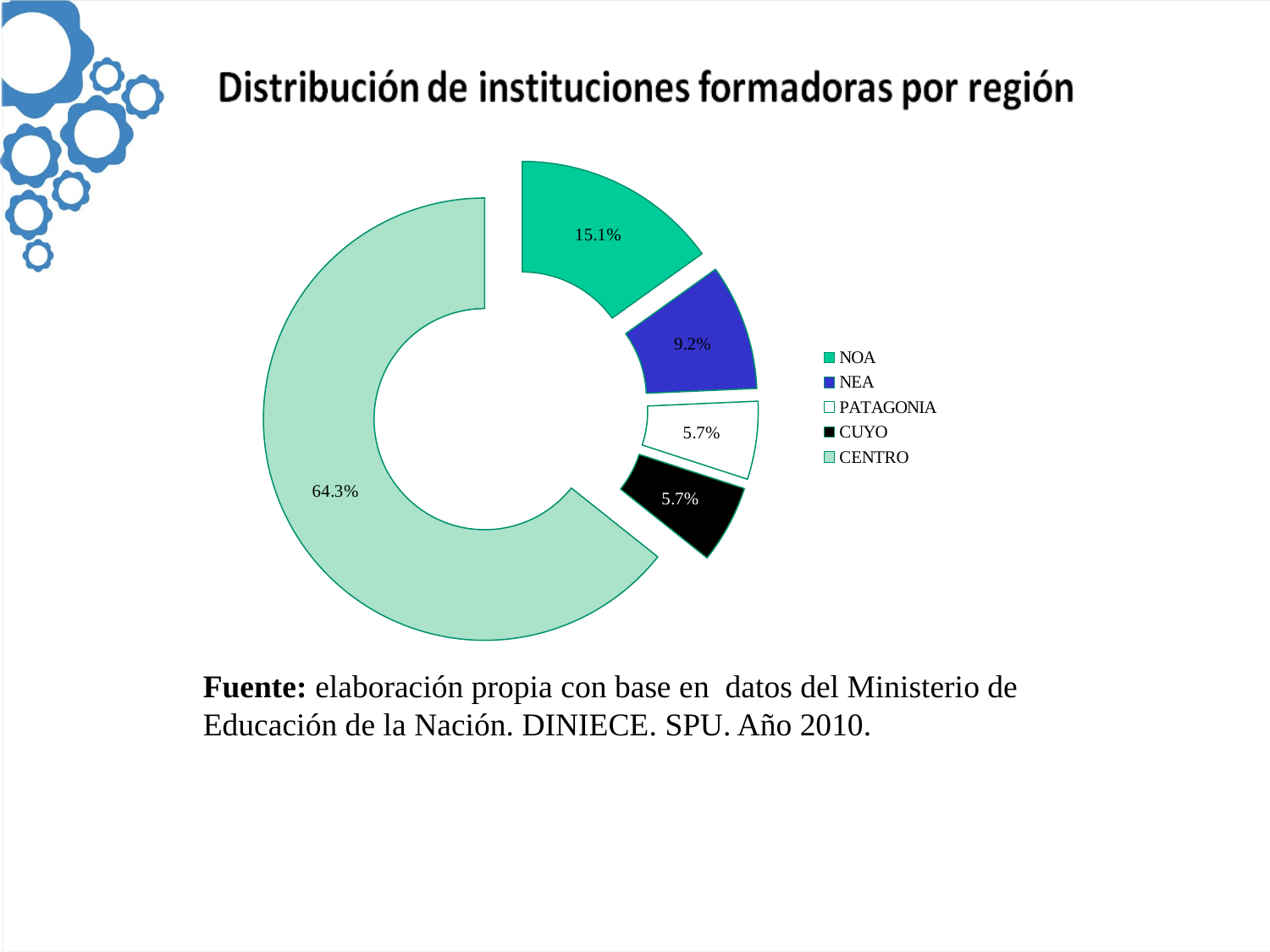
What is the title of the chart? Distribución de instituciones formadoras por región What is the value shown for PATAGONIA? 5.7% Which region has the largest share of the chart? CENTRO What is the value shown for NEA? 9.2% What share of the chart does CENTRO represent? 64.3% What is the difference between the shares of NOA and NEA? 5.9% What is the difference between the shares of CENTRO and NOA? 49.2% What kind of chart is shown on the slide? Doughnut chart What is the value shown for NOA? 15.1% How many regions are shown in the chart? 5 Which region is shown in black in the chart? CUYO Which has a larger share, NEA or CUYO? NEA